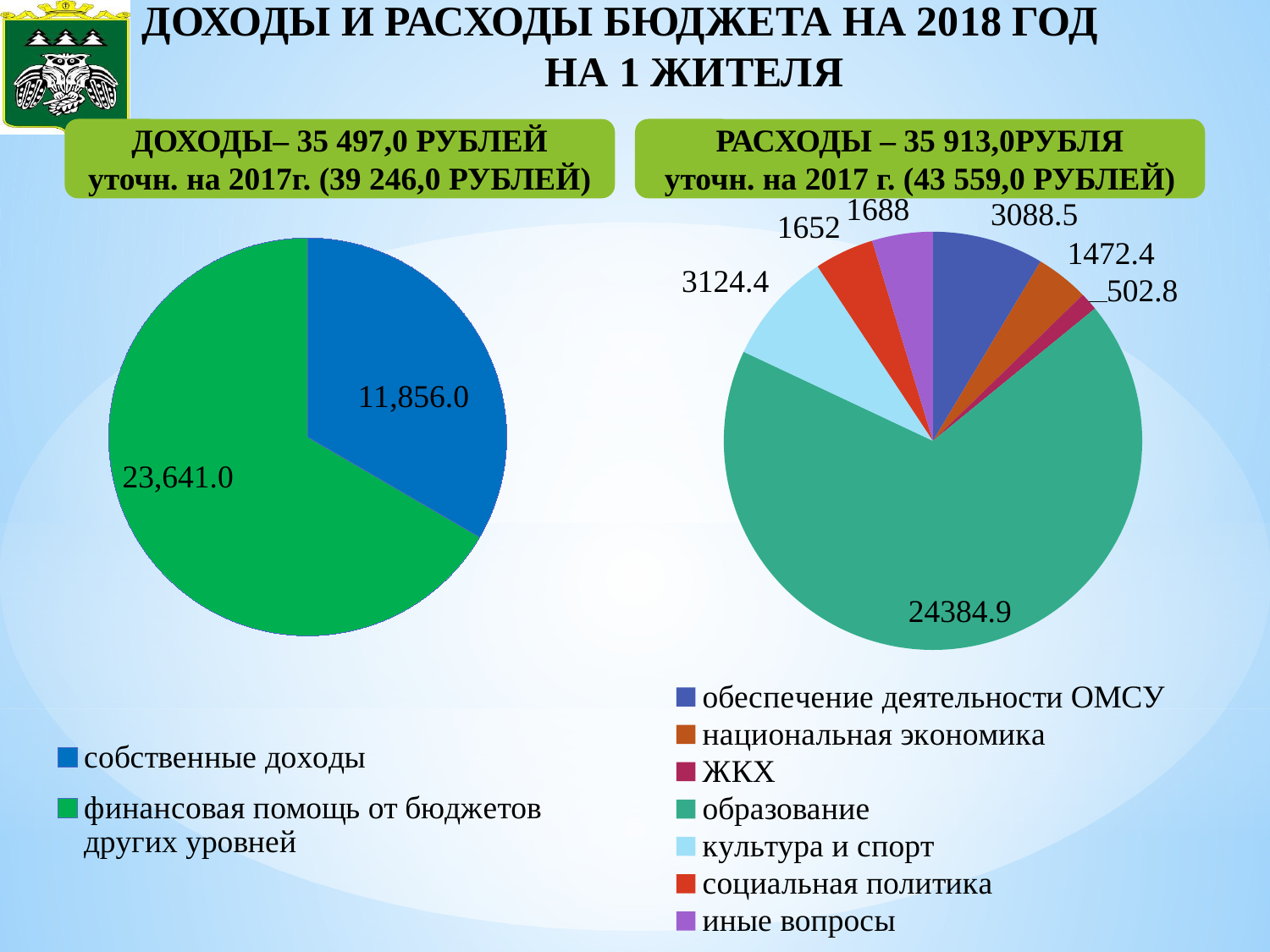
What type of chart is used on the right side of the slide (РАСХОДЫ)? Pie chart In the left pie chart (ДОХОДЫ), how many slices does the pie have? 2 In the left pie chart (ДОХОДЫ), what is the value for финансовая помощь от бюджетов других уровней? 23,641.0 In the right pie chart (РАСХОДЫ), what is the value for образование? 24384.9 In the left pie chart (ДОХОДЫ), what is the difference between финансовая помощь от бюджетов других уровней and собственные доходы? 11,785.0 In the right pie chart (РАСХОДЫ), what is the difference between культура и спорт and обеспечение деятельности ОМСУ? 35.9 In the right pie chart (РАСХОДЫ), how many categories does the legend list? 7 In the left pie chart (ДОХОДЫ), what is the value for собственные доходы? 11,856.0 In the right pie chart (РАСХОДЫ), which is larger: иные вопросы or социальная политика? иные вопросы In the right pie chart (РАСХОДЫ), which category has the largest value? образование In the right pie chart (РАСХОДЫ), which category has the smallest value? ЖКХ In the right pie chart (РАСХОДЫ), what is the value for ЖКХ? 502.8